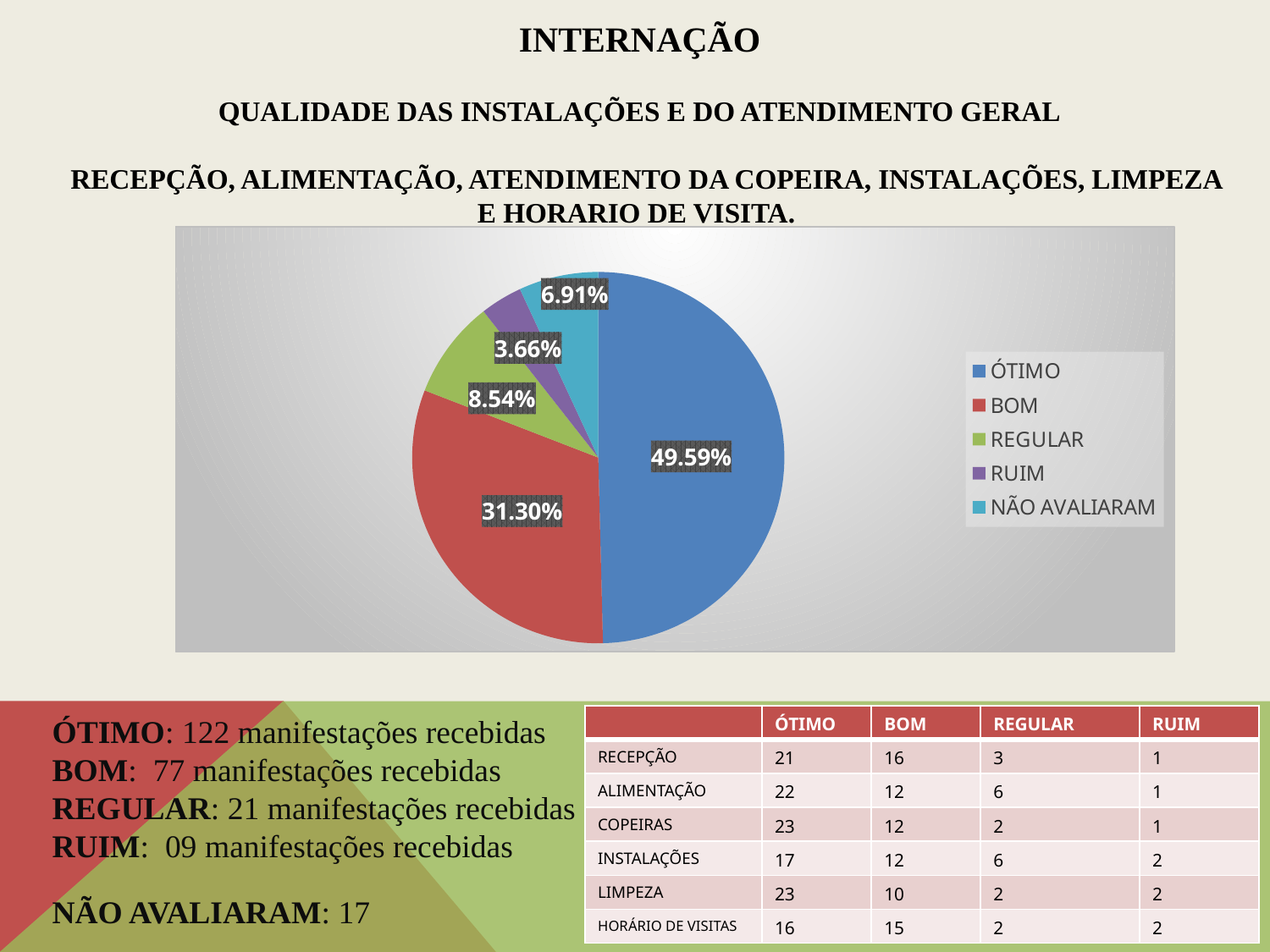
Which category has the largest slice in the pie chart? ÓTIMO What percentage of the pie chart is the RUIM slice? 3.66% What is the difference in percentage points between the ÓTIMO and BOM slices? 18.29% What percentage of the pie chart is the BOM slice? 31.30% What percentage of the pie chart is the REGULAR slice? 8.54% Which slice is larger in the pie chart, REGULAR or NÃO AVALIARAM? REGULAR What kind of chart is shown on the slide? pie chart Which category has the smallest slice in the pie chart? RUIM What percentage of the pie chart is the NÃO AVALIARAM slice? 6.91% How many slices does the pie chart have? 5 What percentage of the pie chart is the ÓTIMO slice? 49.59% How many entries does the pie chart legend list? 5